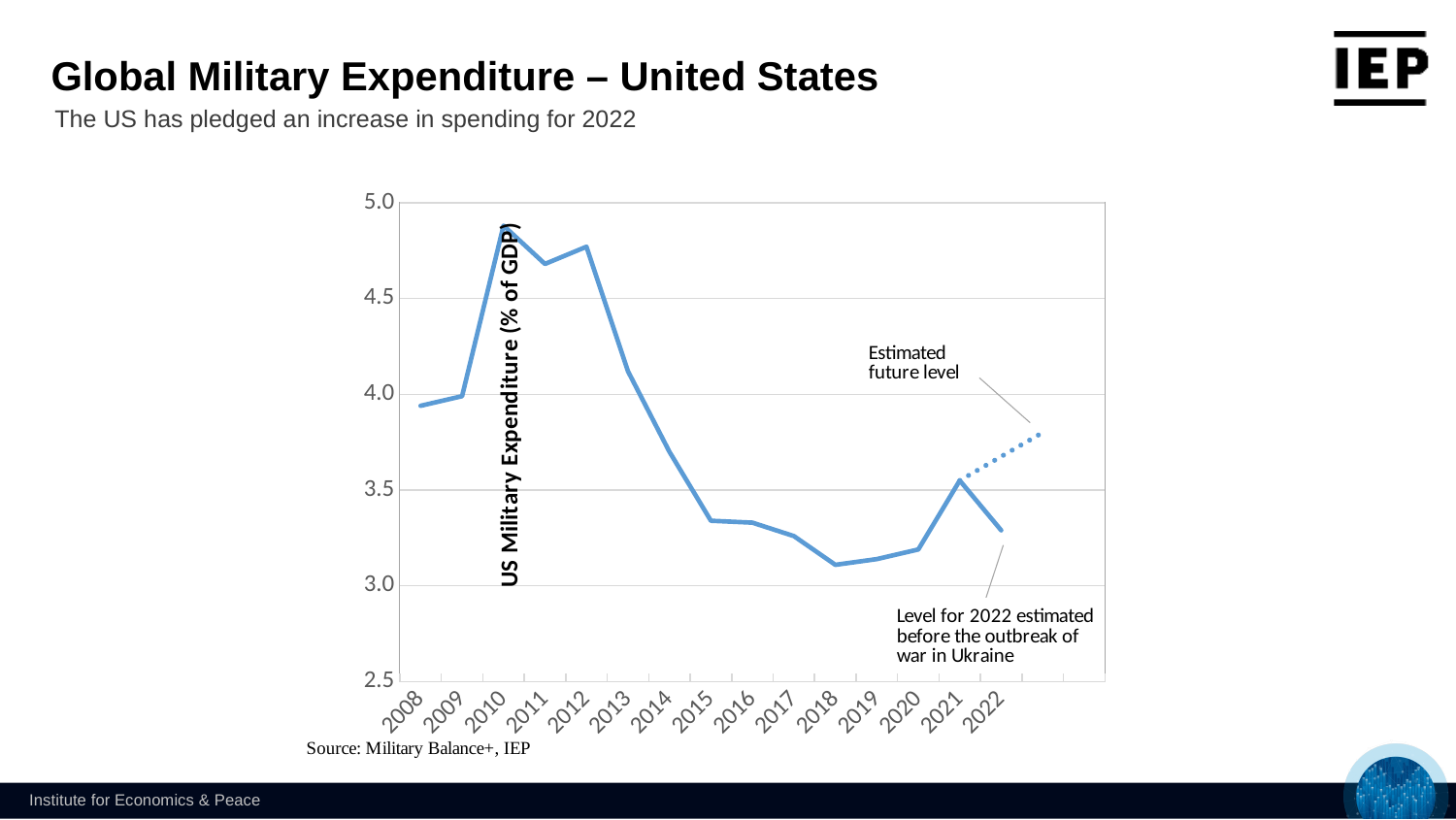
Is the value for 2014 greater or less than 4.0? less What source is cited below the chart? Military Balance+, IEP What is the label on the y axis of the chart? US Military Expenditure (% of GDP) Is the value for 2018 greater or less than 3.5? less Is the value for 2010 larger or smaller than the value for 2015? larger What kind of chart is shown on the slide? Line chart Is the value for 2008 greater or less than 4.0? less Which year has the highest US military expenditure as a share of GDP? 2010 Does the line rise or fall between 2012 and 2018? fall How many years are labelled on the x axis of the chart? 15